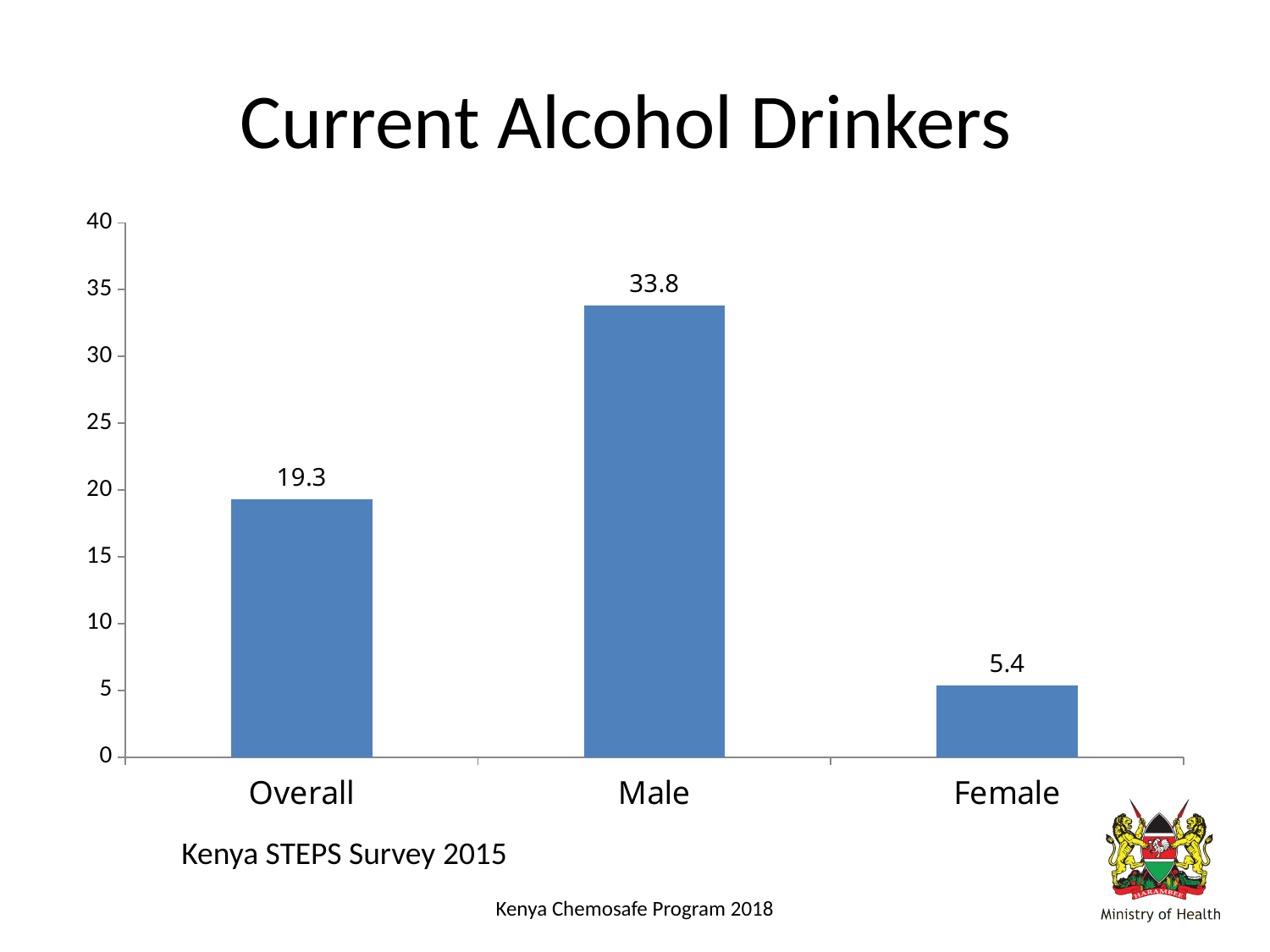
What is the title of the chart? Current Alcohol Drinkers How many categories are shown on the x axis? 3 What is the difference between the Male and Female values? 28.4 Which category has the highest value? Male What is the value for Male? 33.8 Which category has the lowest value? Female What is the value for Female? 5.4 Which is larger, the value for Overall or the value for Female? Overall Is the value for Male greater or less than 30? greater What is the value for Overall? 19.3 What kind of chart is shown on the slide? bar chart What is the difference between the Male and Overall values? 14.5